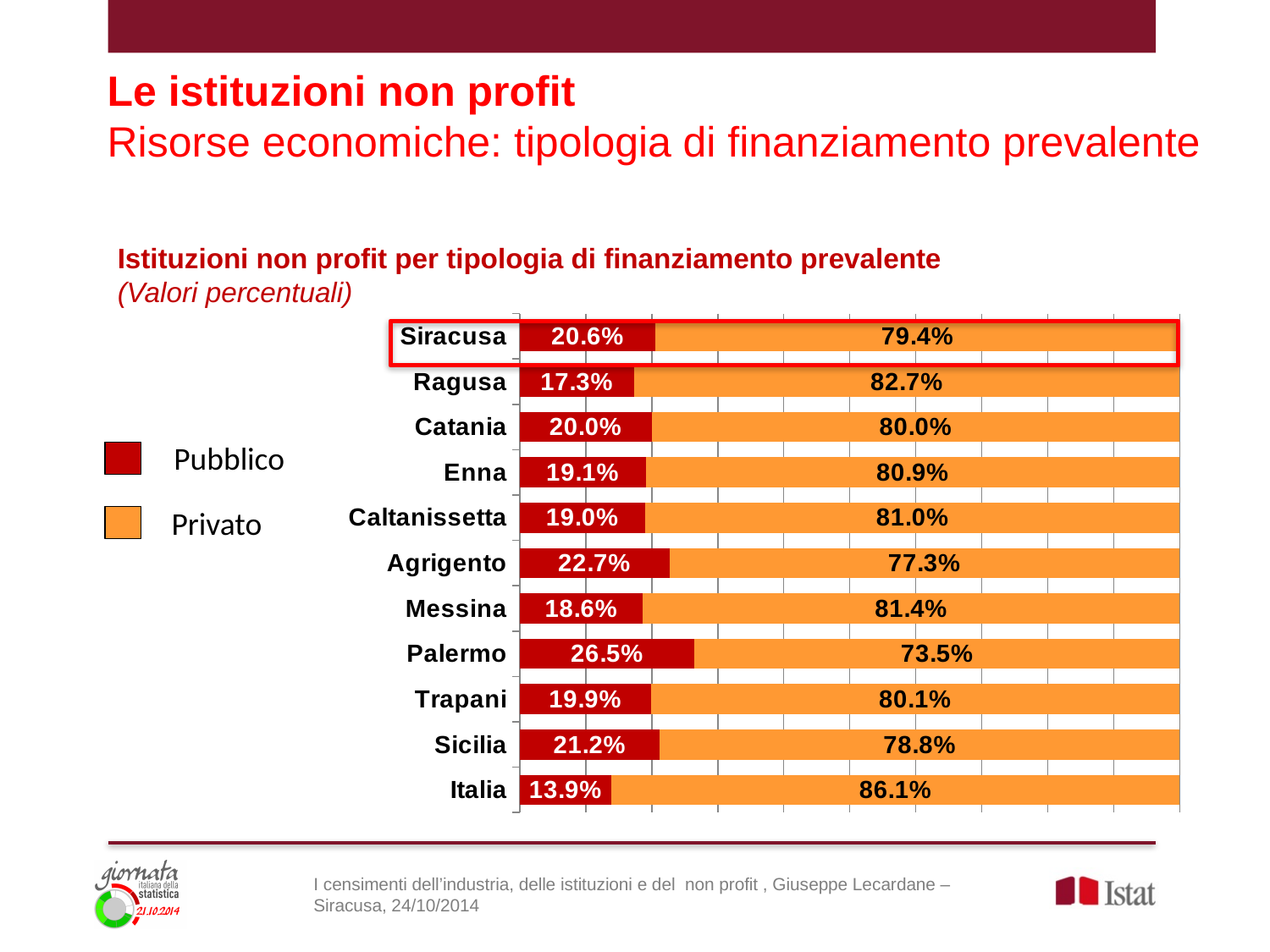
What is the Privato value for Italia? 86.1% How many series does the legend list? 2 What is the Privato value for Palermo? 73.5% Which is larger, the Pubblico value for Agrigento or for Messina? Agrigento Which category has the lowest Pubblico value? Italia What is the Pubblico value for Siracusa? 20.6% How many categories are shown on the chart? 11 Which category has the highest Pubblico value? Palermo Which category has the highest Privato value? Italia What kind of chart is shown on the slide? Stacked bar chart What is the total of the stacked bar for Sicilia? 100.0% What is the difference between the Pubblico values for Palermo and Italia? 12.6%